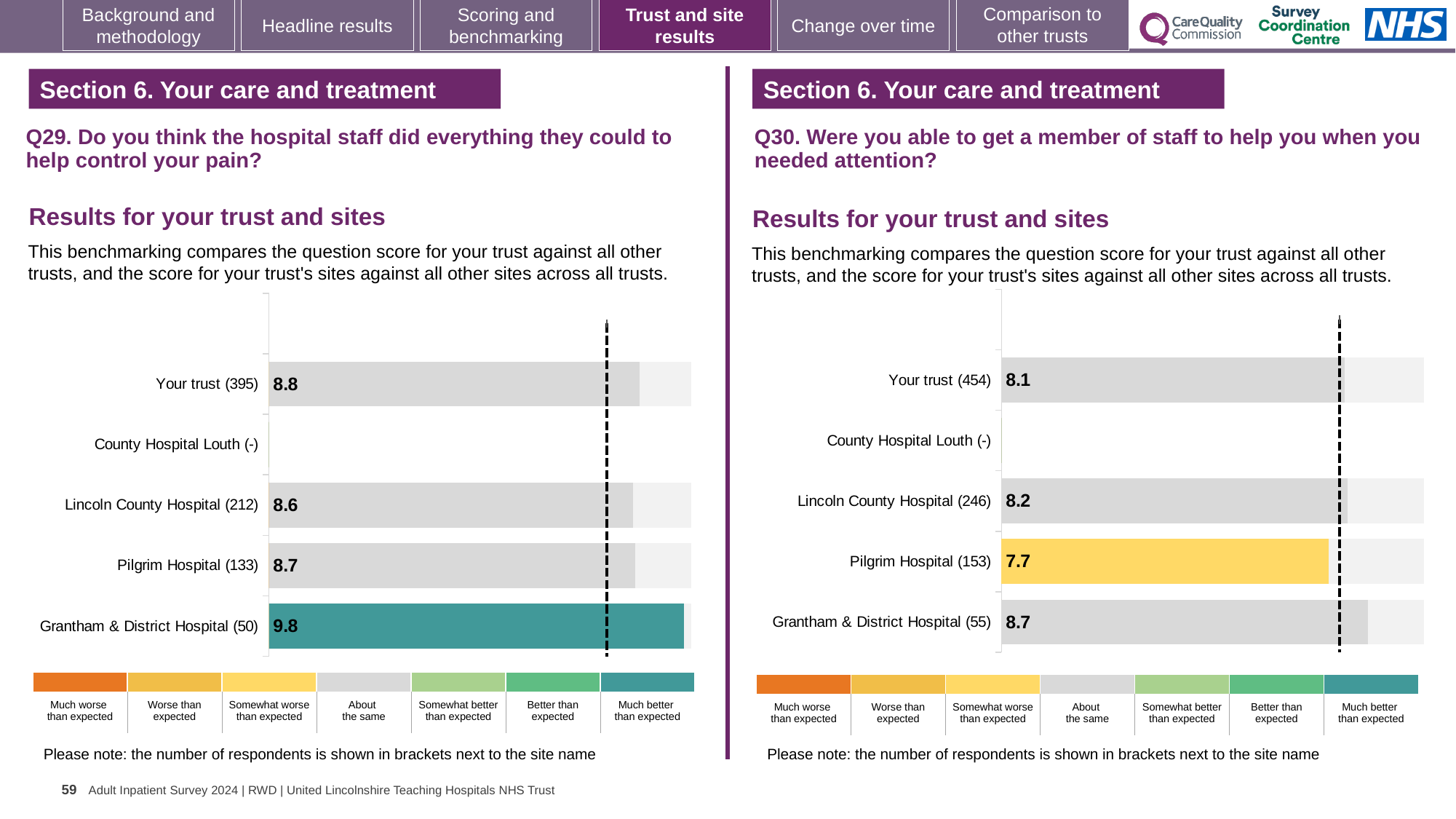
In the Q29 chart on the left, what is the score for Grantham & District Hospital (50)? 9.8 In the Q30 chart on the right, what is the score for Your trust (454)? 8.1 What kind of chart is used for the Q29 results on the left? Bar chart How many categories are listed on the y axis of the Q30 chart on the right? 5 In the Q30 chart on the right, what is the score for Pilgrim Hospital (153)? 7.7 In the Q29 chart on the left, which site has the highest score? Grantham & District Hospital (50) In the Q30 chart on the right, which site has the lowest score? Pilgrim Hospital (153) In the Q29 chart on the left, what is the score for Your trust (395)? 8.8 In the Q29 chart on the left, which has the higher score, Pilgrim Hospital (133) or Lincoln County Hospital (212)? Pilgrim Hospital (133) In the Q30 chart on the right, what is the difference between the scores for Grantham & District Hospital (55) and Pilgrim Hospital (153)? 1.0 In the Q29 chart on the left, what is the difference between the scores for Grantham & District Hospital (50) and Lincoln County Hospital (212)? 1.2 In the Q30 chart on the right, which benchmark category does the colour of the Pilgrim Hospital (153) bar correspond to? Somewhat worse than expected